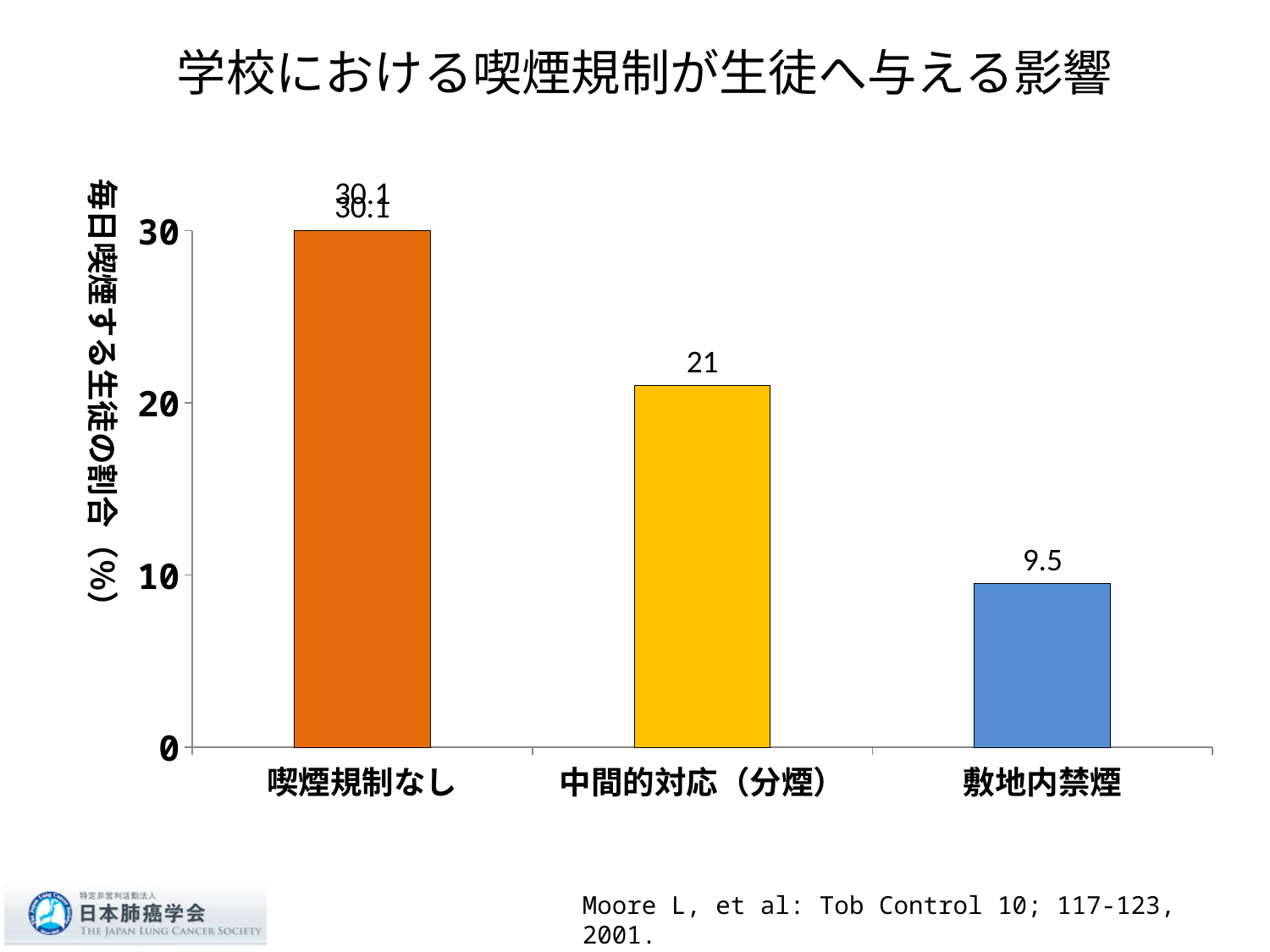
What kind of chart is shown on the slide? bar chart What is the difference between the values for 中間的対応（分煙） and 敷地内禁煙? 11.5 Is the value for 中間的対応（分煙） greater or less than 20? greater What is the difference between the values for 喫煙規制なし and 敷地内禁煙? 20.6 Which category has the lowest value? 敷地内禁煙 Do the values rise or fall from left to right along the x axis? fall Which category has the highest value? 喫煙規制なし Which is larger, the value for 中間的対応（分煙） or the value for 敷地内禁煙? 中間的対応（分煙） What is the value for 中間的対応（分煙）? 21 What is the value for 喫煙規制なし? 30.1 How many categories are shown on the x axis? 3 What is the value for 敷地内禁煙? 9.5